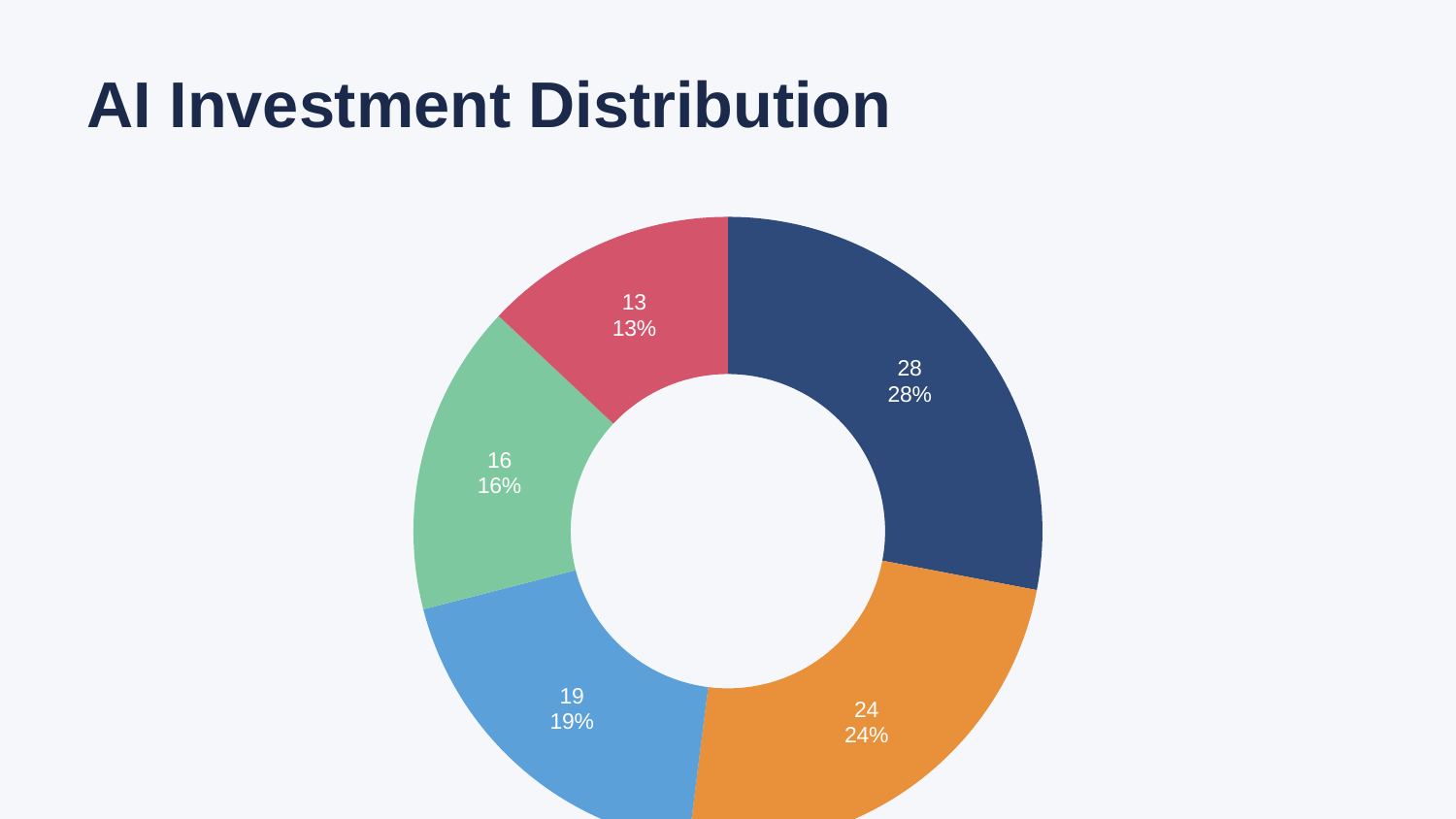
What is the difference between the largest slice value (28) and the smallest slice value (13)? 15 What is the total of all slice values in the pie chart? 100 How many slices does the pie chart have? 5 What is the smallest value shown on the pie chart? 13 What is the title of the chart on the slide? AI Investment Distribution Which is larger, the slice valued 16 or the slice valued 19? 19 What is the difference between the slice valued 24 and the slice valued 19? 5 What kind of chart is shown on the slide? Pie chart (donut) What value is shown on the dark blue slice of the pie chart? 28 What percentage share does the largest slice of the pie chart have? 28% What percentage share does the smallest slice of the pie chart have? 13% What is the largest value shown on the pie chart? 28